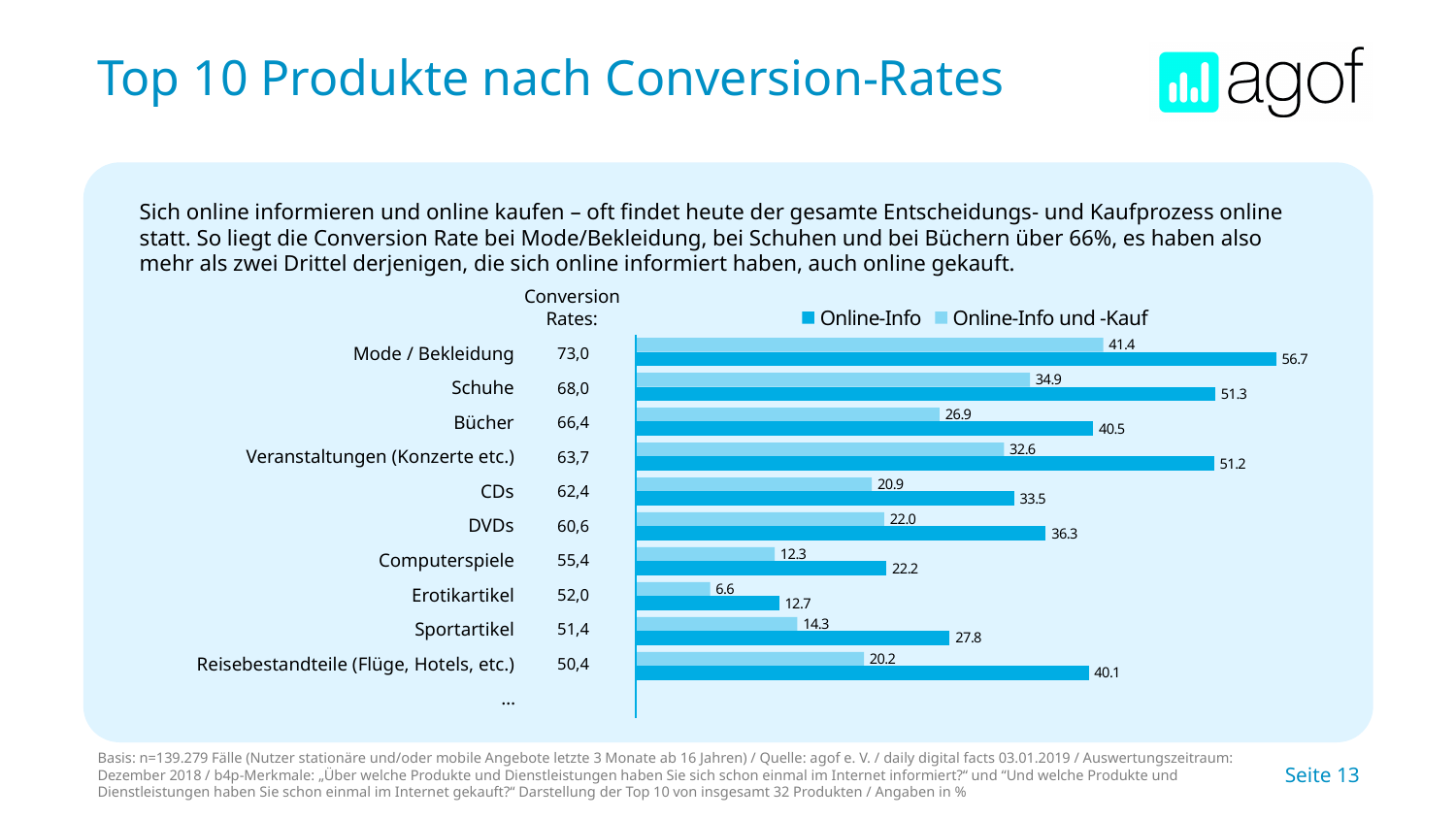
What are the two series named in the legend? Online-Info and Online-Info und -Kauf What is the Online-Info value for Mode / Bekleidung? 56.7 Which category has the highest Online-Info value? Mode / Bekleidung How many product categories are plotted in the chart? 10 How many series does the legend list? 2 What is the Online-Info und -Kauf value for Schuhe? 34.9 What kind of chart is shown on the slide? Bar chart Which has the larger Online-Info value, DVDs or CDs? DVDs What is the difference between the Online-Info and the Online-Info und -Kauf values for Mode / Bekleidung? 15.3 What is the difference between the Online-Info and the Online-Info und -Kauf values for Computerspiele? 9.9 Which category has the lowest Online-Info und -Kauf value? Erotikartikel What is the Online-Info value for Sportartikel? 27.8